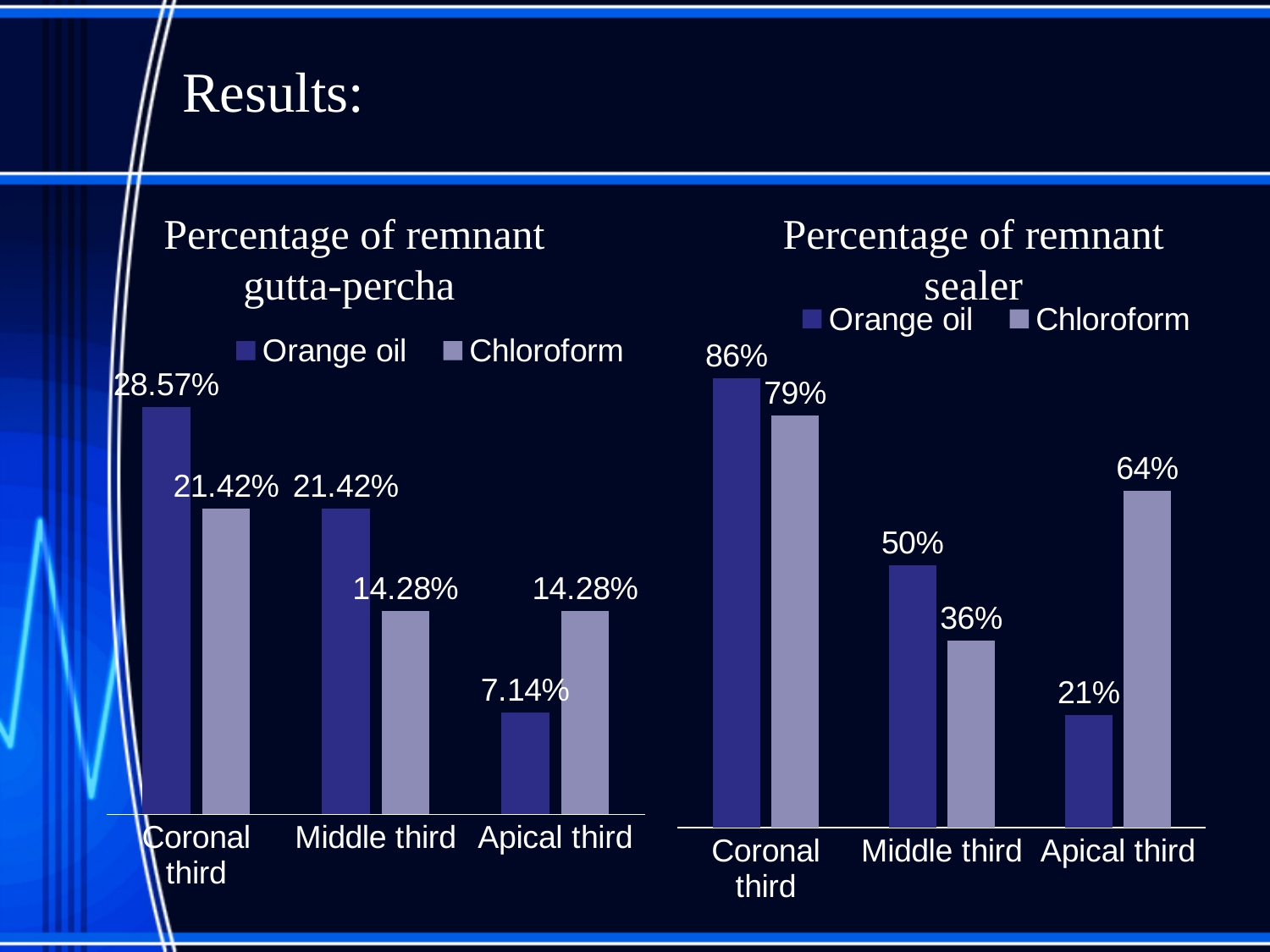
In the 'Percentage of remnant gutta-percha' chart, what is the Orange oil value for the Coronal third? 28.57% In the 'Percentage of remnant gutta-percha' chart, do the Orange oil values rise or fall from Coronal third to Apical third? fall In the 'Percentage of remnant sealer' chart, which is larger for the Apical third, Orange oil or Chloroform? Chloroform In the 'Percentage of remnant gutta-percha' chart, which category has the lowest Orange oil value? Apical third What kind of chart is the 'Percentage of remnant sealer' chart? bar chart In the 'Percentage of remnant sealer' chart, what is the Chloroform value for the Middle third? 36% In the 'Percentage of remnant gutta-percha' chart, what is the Chloroform value for the Apical third? 14.28% In the 'Percentage of remnant sealer' chart, what is the difference between the Orange oil and Chloroform values for the Coronal third? 7% In the 'Percentage of remnant gutta-percha' chart, what is the difference between the Orange oil and Chloroform values for the Middle third? 7.14% In the 'Percentage of remnant gutta-percha' chart, how many series does the legend list? 2 In the 'Percentage of remnant sealer' chart, which category has the highest Chloroform value? Coronal third In the 'Percentage of remnant sealer' chart, what is the Orange oil value for the Apical third? 21%